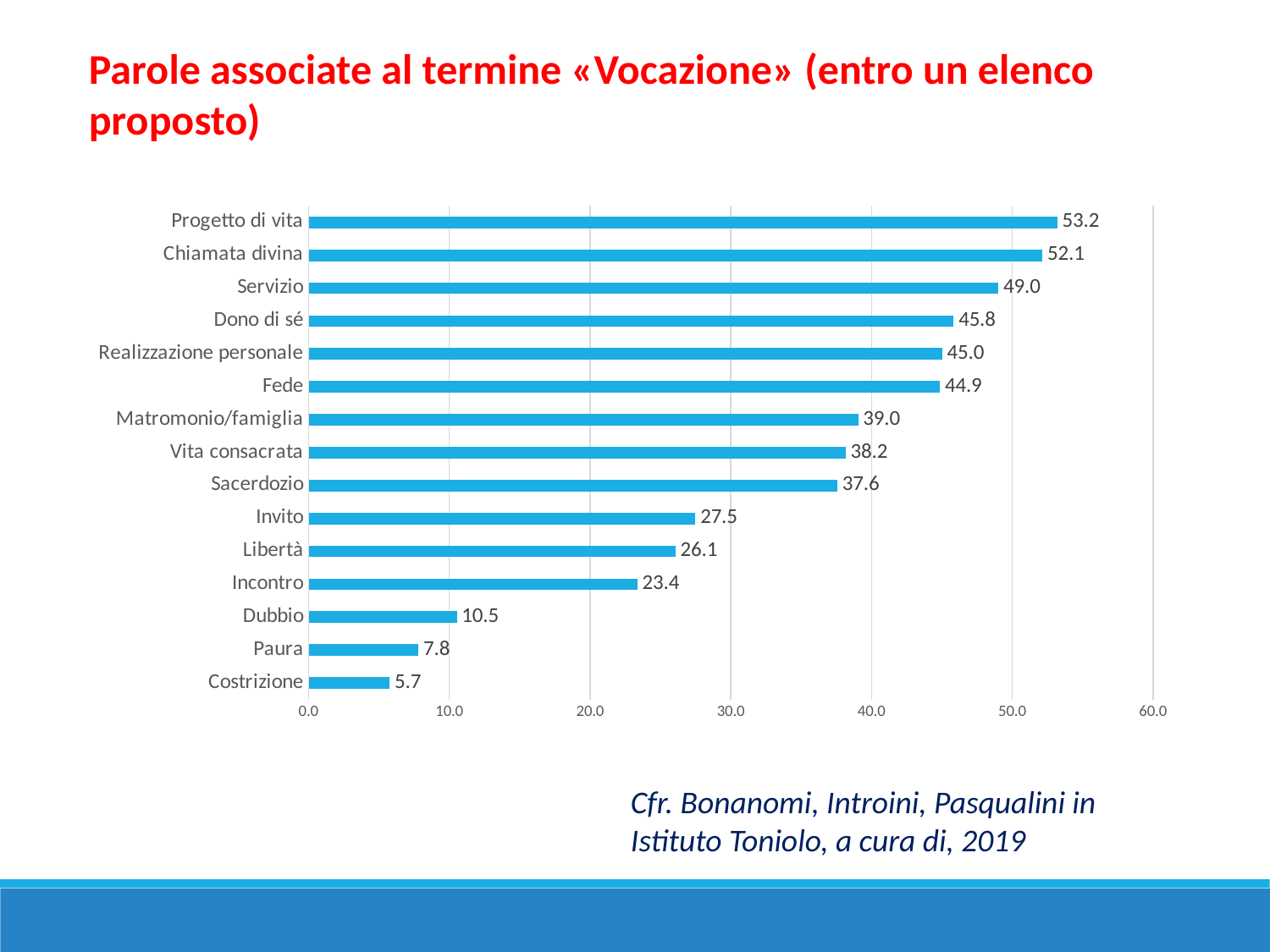
Which has a larger value, Invito or Libertà? Invito What is the difference between the values for Paura and Costrizione? 2.1 What is the difference between the values for Servizio and Fede? 4.1 Which category has the lowest value? Costrizione What is the value for Progetto di vita? 53.2 Which category has the highest value? Progetto di vita What kind of chart is shown on the slide? Bar chart What is the value for Dubbio? 10.5 What is the value for Sacerdozio? 37.6 How many categories are shown in the chart? 15 What is the maximum value shown on the horizontal axis? 60.0 Is the value for Matromonio/famiglia greater or less than 30.0? greater